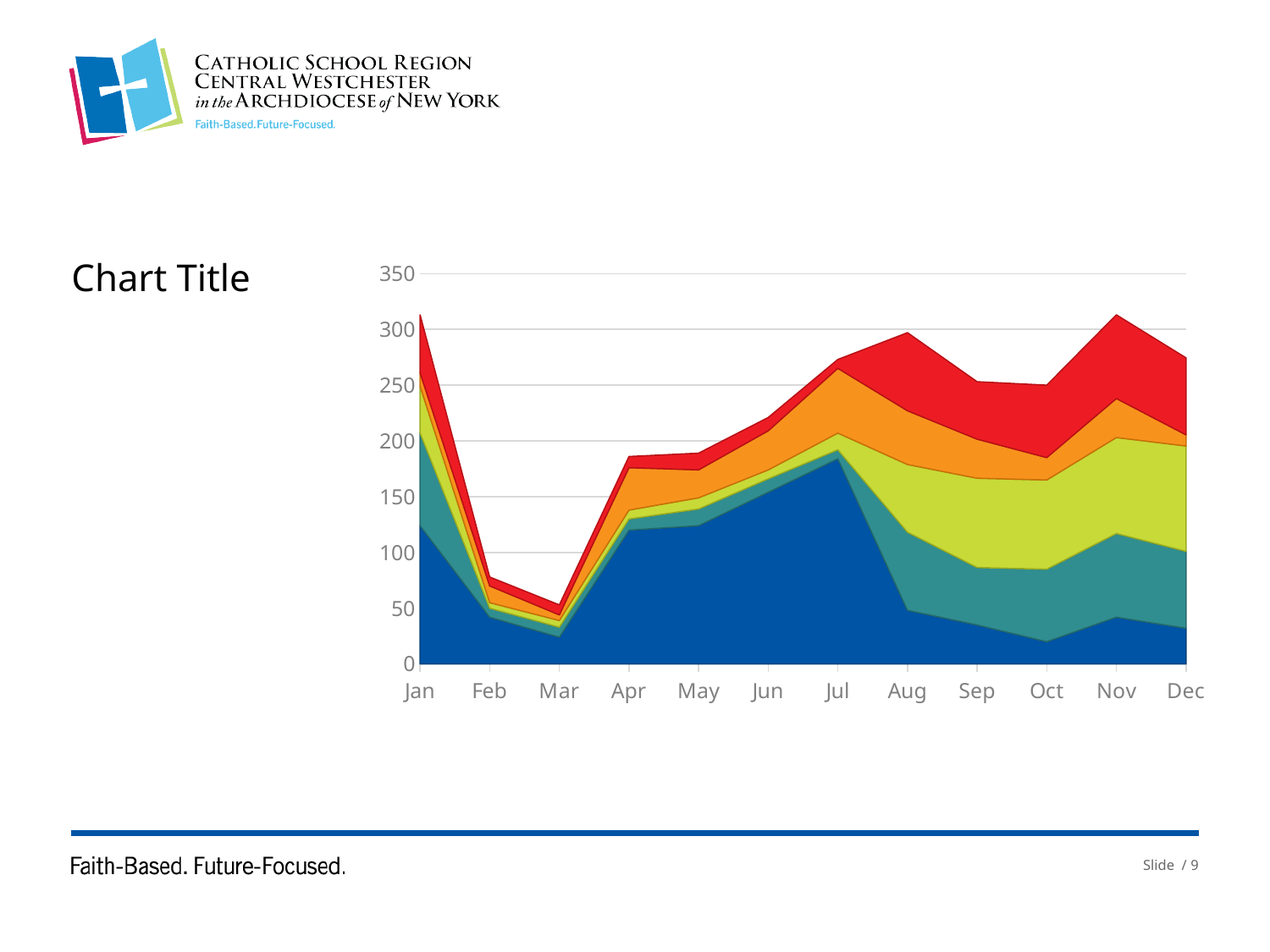
How many months are shown along the x axis of the chart? 12 What is the title of the chart? Chart Title Is the total value for Apr greater or less than 200? less Which month has the larger total, Aug or Sep? Aug Is the total value for Jul greater or less than 250? greater Is the total value for Aug greater or less than 250? greater What kind of chart is shown on the slide? Stacked area chart Which month has the larger total, Feb or Mar? Feb Do the total values rise or fall from Mar to Jul? rise How many coloured series are stacked in the chart? 5 Which month has the lowest total (top of the stacked area)? Mar